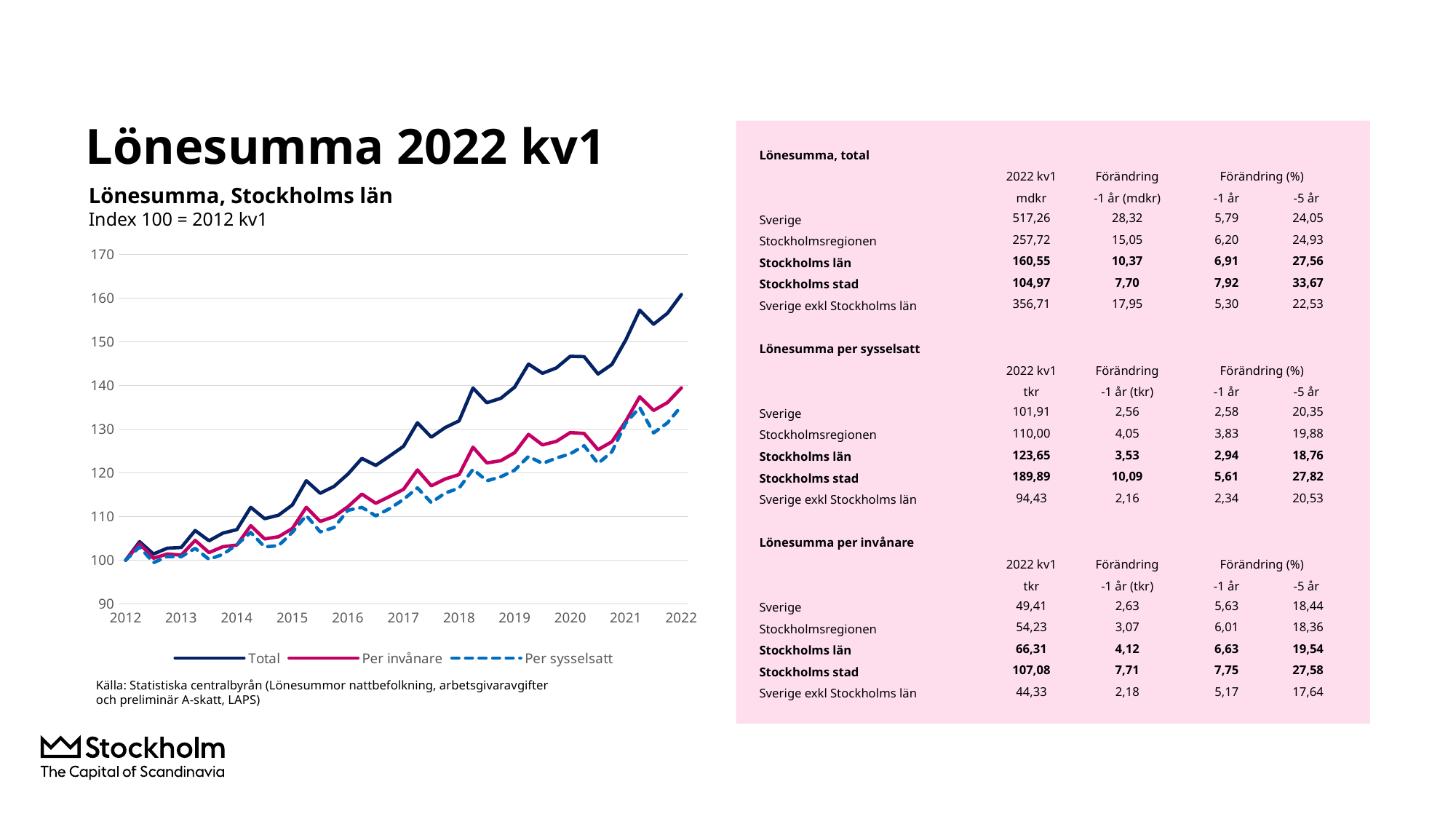
Is the value of the Total series at 2017 greater or less than 120? greater What kind of chart is shown on the slide? line chart How many series does the chart legend list? 3 Does the Total series rise or fall from 2012 to 2022? rise Is the value of the Per invånare series at 2022 greater or less than 130? greater What is the title of the chart? Lönesumma, Stockholms län Which series has the highest value at 2022? Total What are the three series listed in the chart legend? Total, Per invånare, Per sysselsatt How many years are labelled on the x axis of the chart? 11 At 2022, which is larger: the Total series or the Per sysselsatt series? Total Is the value of the Total series at 2022 greater or less than 150? greater